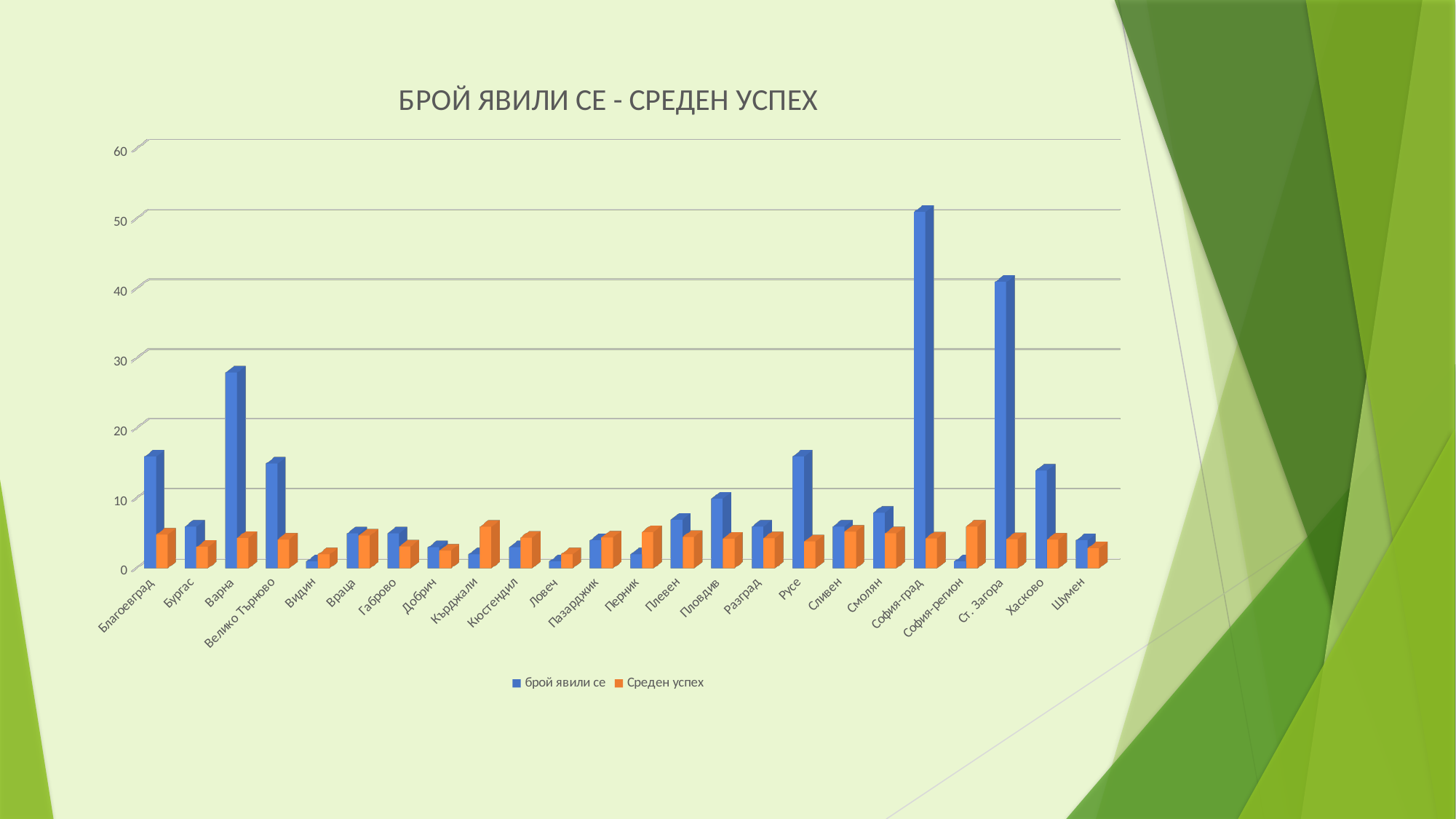
Is the value of брой явили се for София-град greater or less than 40? greater What kind of chart is shown on the slide? bar chart Which has the larger value for брой явили се, София-град or Ст. Загора? София-град Is the value of брой явили се for Варна greater or less than 20? greater Is the value of брой явили се for Ст. Загора greater or less than 30? greater How many categories are shown on the x axis? 24 How many series does the legend list? 2 Which has the larger value for брой явили се, Варна or Велико Търново? Варна Which category has the highest value for брой явили се? София-град Which series is shown in orange? Среден успех What is the title of the chart? БРОЙ ЯВИЛИ СЕ - СРЕДЕН УСПЕХ